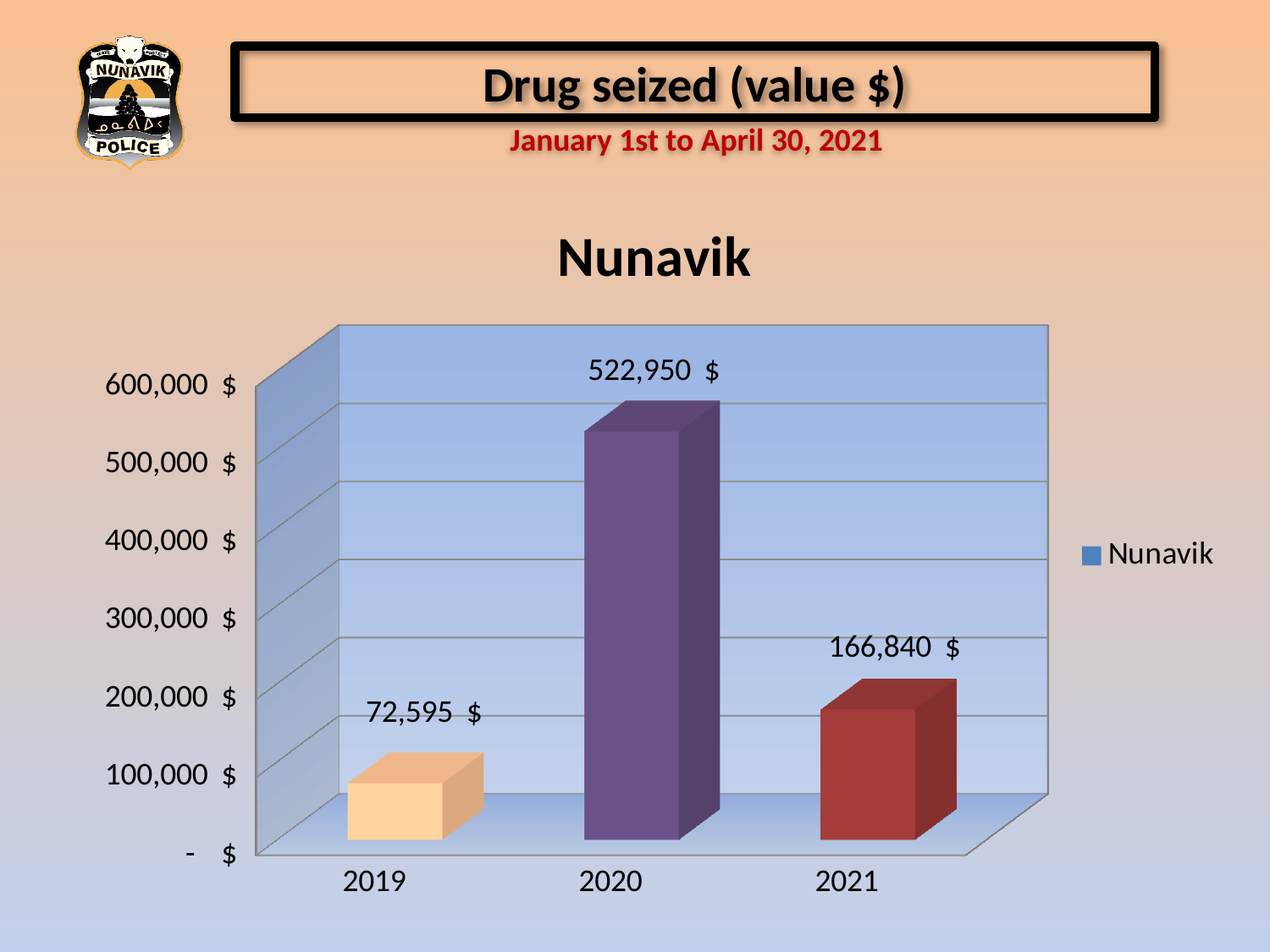
What kind of chart is shown on the slide? bar chart What is the value of drugs seized in 2019? 72,595 $ What is the value of drugs seized in 2021? 166,840 $ Which year has the lowest value of drugs seized? 2019 Which year has the highest value of drugs seized? 2020 What is the difference between the values for 2020 and 2021? 356,110 $ Which is larger, the value for 2019 or the value for 2021? 2021 What is the title of the chart? Nunavik How many years are shown on the chart? 3 Is the value for 2020 greater or less than 500,000 $? greater What is the difference between the values for 2021 and 2019? 94,245 $ What is the value of drugs seized in 2020? 522,950 $